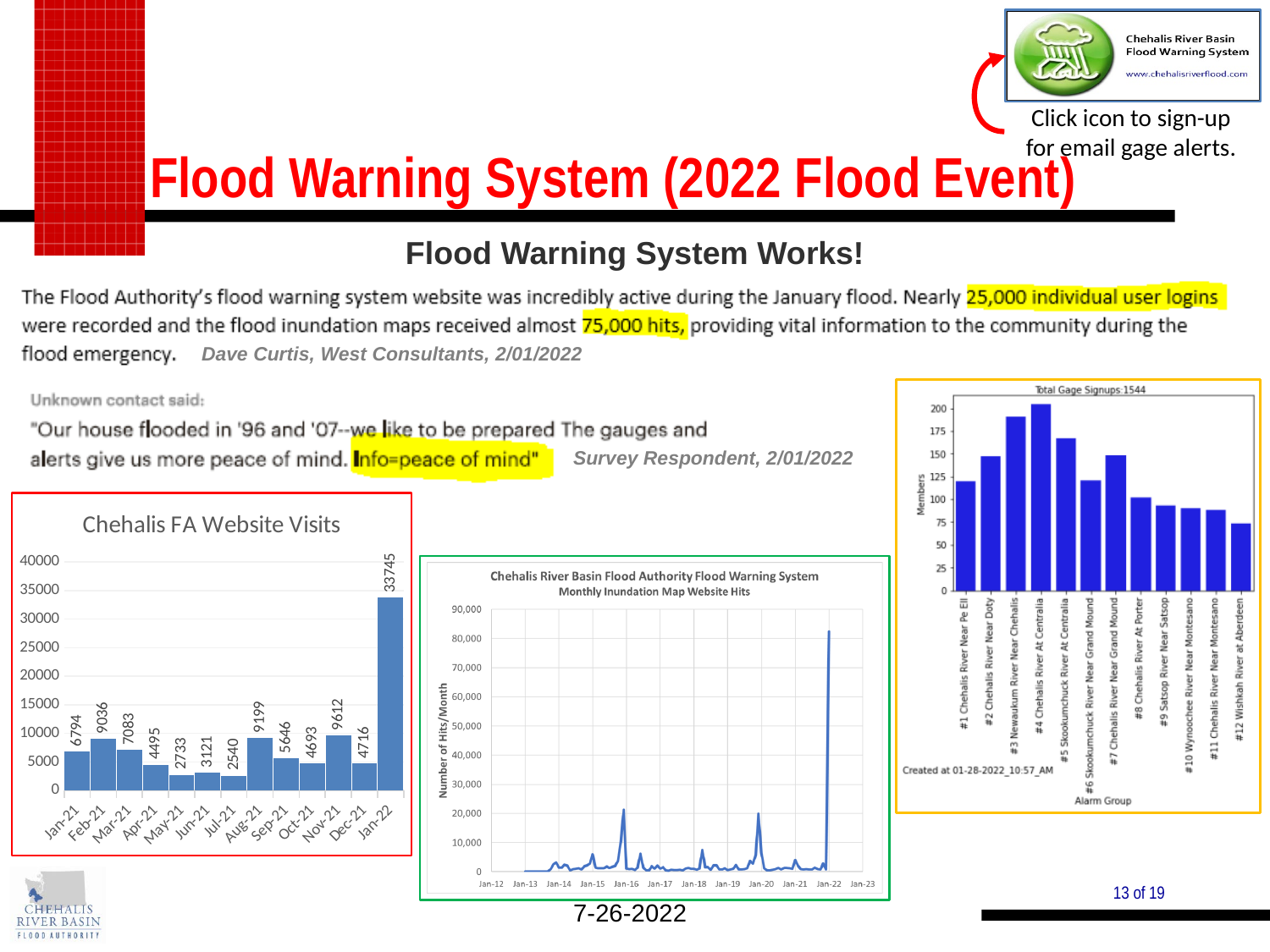
In the Chehalis FA Website Visits chart, what is the difference between Nov-21 and Dec-21? 4896 In the Chehalis FA Website Visits chart, which month has the lowest value? Jul-21 In the Total Gage Signups chart, which alarm group has the most members? #4 Chehalis River At Centralia In the Monthly Inundation Map Website Hits chart, is the peak value near Jan-22 greater or less than 80,000? greater In the Chehalis FA Website Visits chart, which is larger, Feb-21 or Mar-21? Feb-21 In the Chehalis FA Website Visits chart, what is the value for Aug-21? 9199 How many months are shown in the Chehalis FA Website Visits chart? 13 In the Chehalis FA Website Visits chart, what is the value for Jan-22? 33745 What kind of chart is the Chehalis River Basin Flood Authority Flood Warning System Monthly Inundation Map Website Hits chart? line chart In the Total Gage Signups chart, is the value for #3 Newaukum River Near Chehalis greater or less than 175? greater In the Chehalis FA Website Visits chart, which month has the highest value? Jan-22 In the Total Gage Signups chart, which alarm group has the fewest members? #12 Wishkah River at Aberdeen